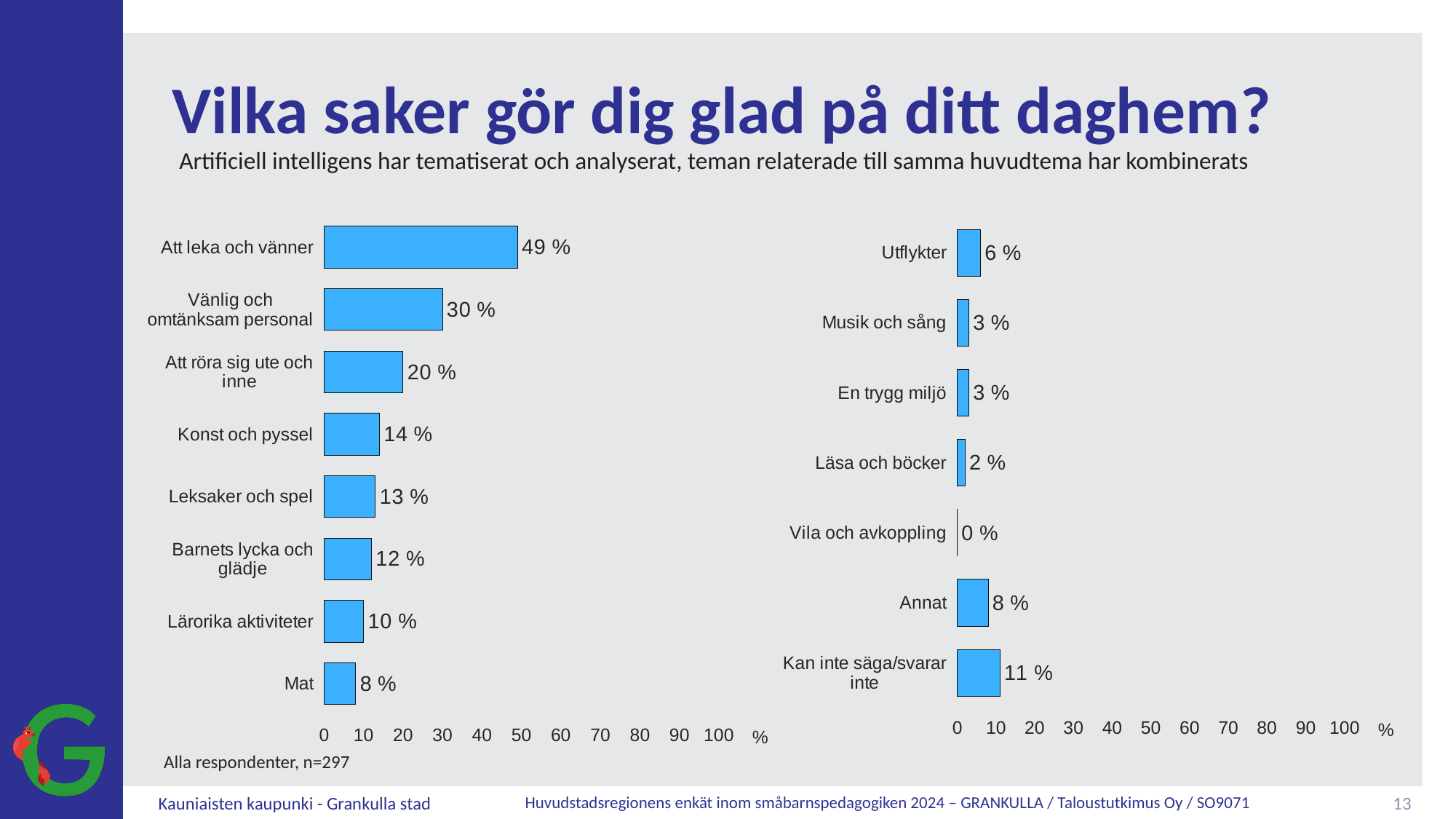
How many categories are shown in the right chart? 7 In the left chart, what is the difference between Att leka och vänner and Vänlig och omtänksam personal? 19 % In the left chart, what is the value for Att leka och vänner? 49 % In the left chart, what is the value for Konst och pyssel? 14 % In the right chart, which category has the lowest value? Vila och avkoppling In the right chart, which is larger: Annat or Utflykter? Annat In the right chart, what is the value for Kan inte säga/svarar inte? 11 % In the right chart, what is the value for Utflykter? 6 % What type of chart is used on this slide? Bar chart In the left chart, which category has the lowest value? Mat How many categories are shown in the left chart? 8 In the right chart, which category has the highest value? Kan inte säga/svarar inte